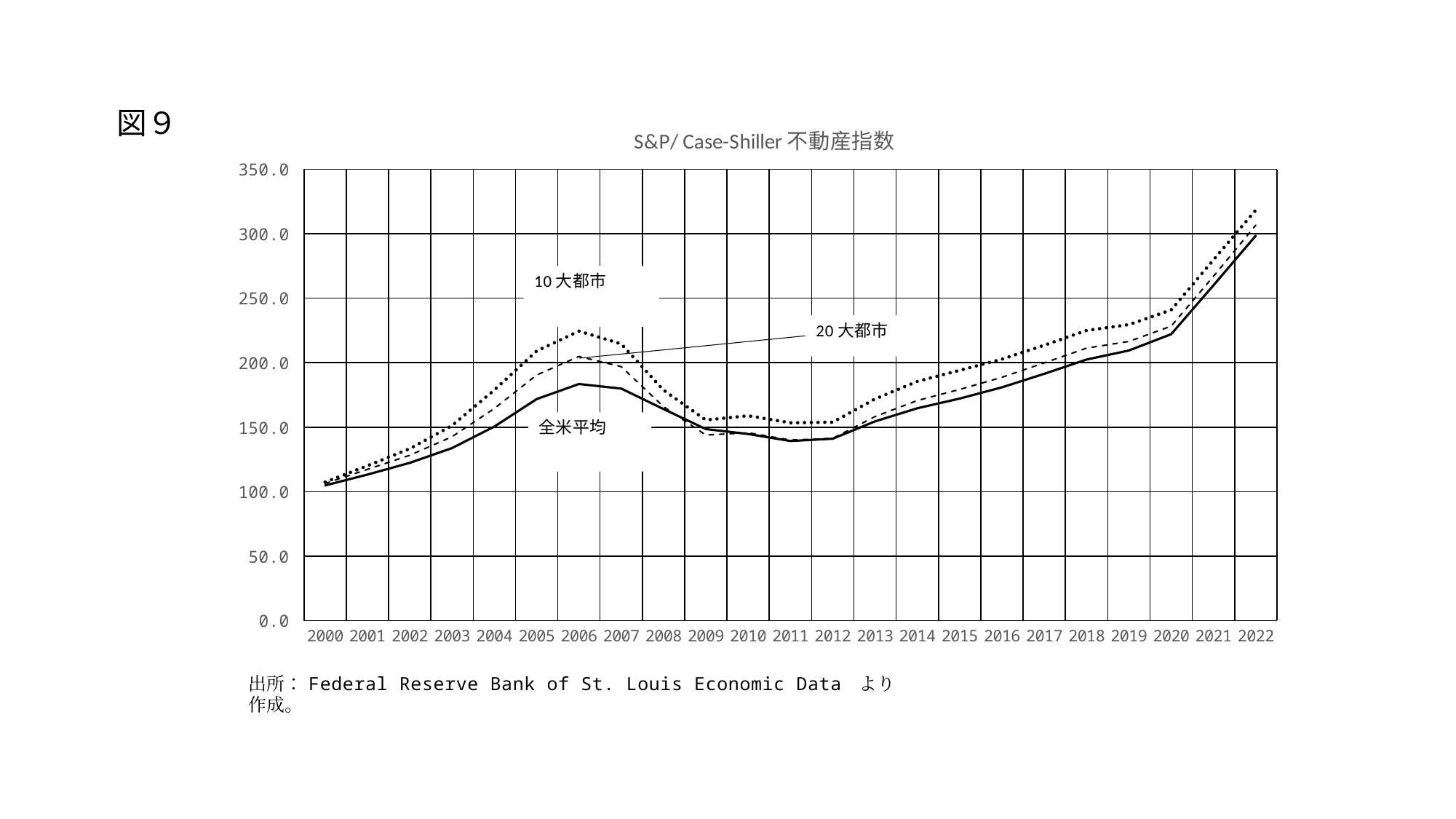
Is the value for 全米平均 in 2006 greater or less than 200? less In which year does the 全米平均 series reach its highest value? 2022 In which year is the 10大都市 series at its lowest value? 2000 Which series is drawn as a solid line? 全米平均 How many years are plotted along the x axis? 23 What kind of chart is shown on the slide? line chart Does the 全米平均 series rise or fall between 2006 and 2011? fall How many series are plotted in the chart? 3 Is the value for 10大都市 in 2006 greater or less than 200? greater What is the title of the chart? S&P/ Case-Shiller 不動産指数 In 2006, which series has the higher value, 10大都市 or 全米平均? 10大都市 Is the value for 10大都市 in 2022 greater or less than 300? greater